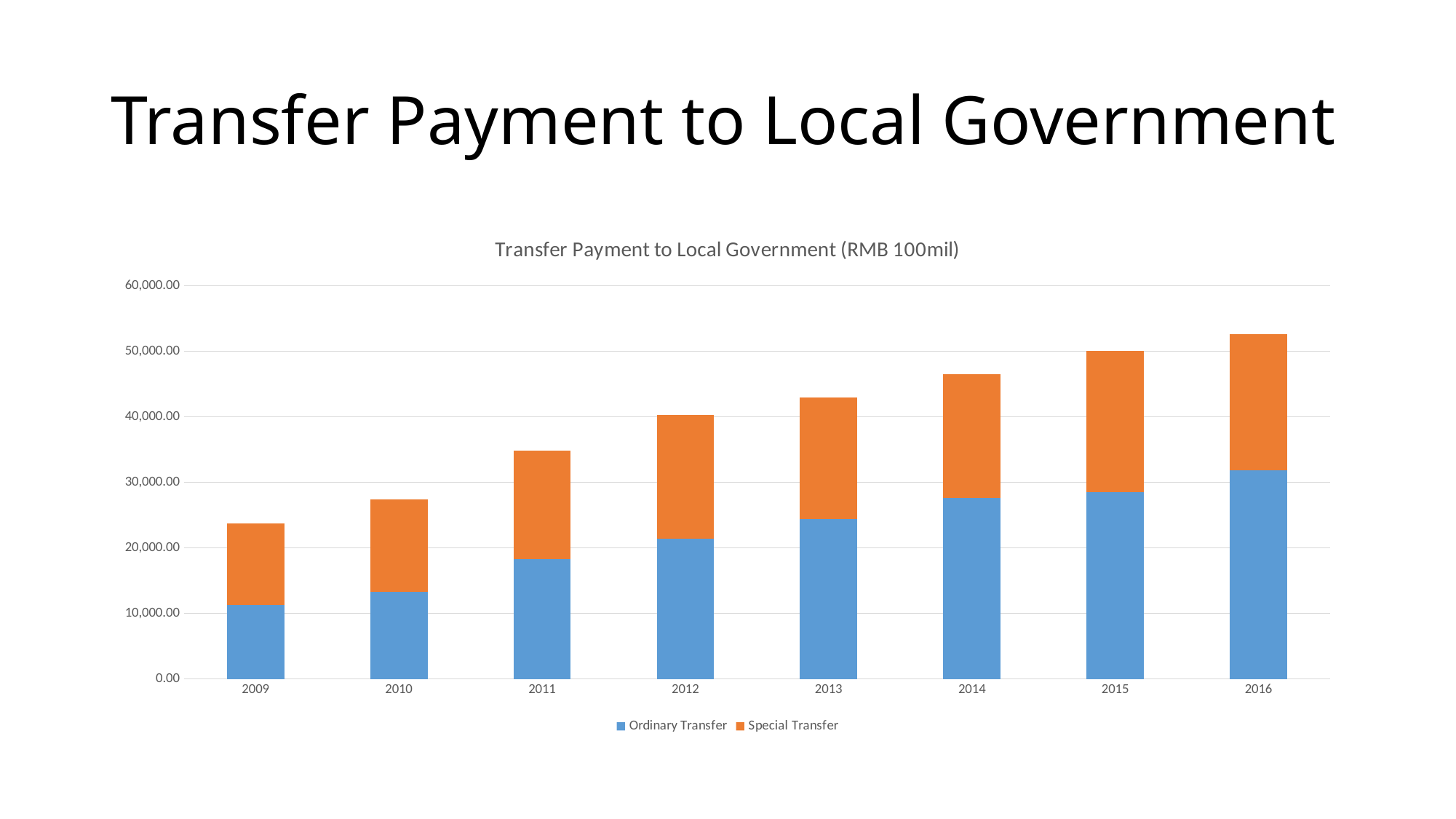
How many years are shown on the x axis? 8 Is the total transfer payment for 2011 greater or less than 40,000.00? less What kind of chart is shown on the slide? Stacked bar chart Which year has the highest total transfer payment? 2016 Which year has the lowest total transfer payment? 2009 Is the total transfer payment for 2016 greater or less than 50,000.00? greater Is the Ordinary Transfer value for 2009 greater or less than 10,000.00? greater What unit is given in the chart title? RMB 100mil How many series does the legend list? 2 Do the total transfer payments rise or fall from 2009 to 2016? Rise Which is larger, the Ordinary Transfer for 2014 or the Ordinary Transfer for 2010? 2014